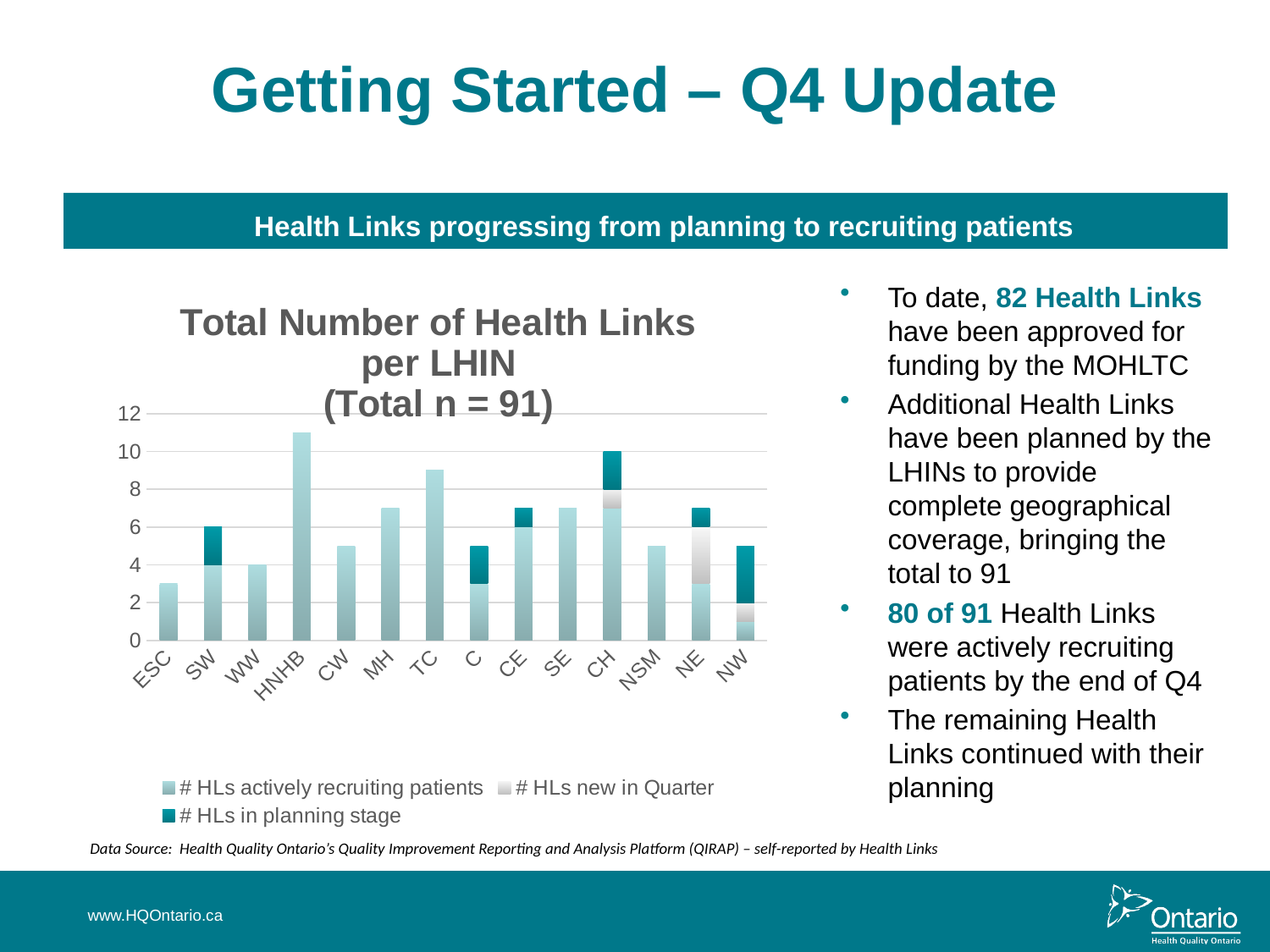
Which series in the legend is shown in the darkest teal colour? # HLs in planning stage Which bar is taller, TC or CW? TC What kind of chart is shown on the slide? Bar chart Is the total bar height for ESC greater or less than 4? less How many series does the chart's legend list? 3 Is the total bar height for NSM greater or less than 6? less Which LHIN has the shortest bar in the chart? ESC How many LHIN categories are shown on the x axis of the chart? 14 Is the total bar height for TC greater or less than 8? greater Which LHIN has the tallest bar in the chart? HNHB What is the title of the chart? Total Number of Health Links per LHIN (Total n = 91)